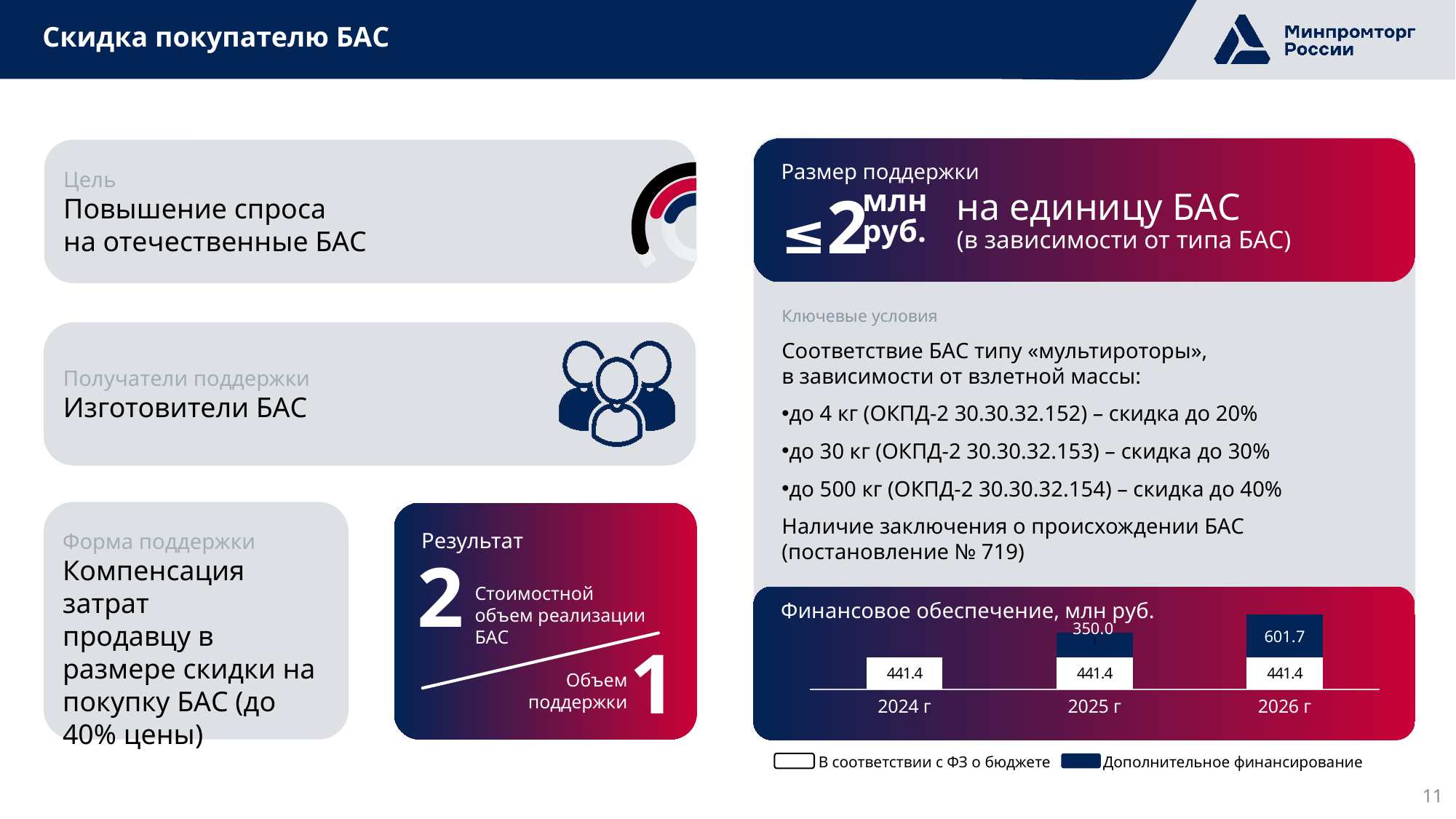
What type of chart is shown under "Финансовое обеспечение, млн руб."? Stacked bar chart In the "Финансовое обеспечение, млн руб." chart, which year has the highest "Дополнительное финансирование" value? 2026 г In the "Финансовое обеспечение, млн руб." chart, what is the total of the stacked bar for 2025 г? 791.4 In the "Финансовое обеспечение, млн руб." chart, what is the value for "Дополнительное финансирование" in 2026 г? 601.7 How many series does the legend of the "Финансовое обеспечение, млн руб." chart list? 2 In the "Финансовое обеспечение, млн руб." chart, is the "Дополнительное финансирование" value for 2026 г larger or smaller than the "В соответствии с ФЗ о бюджете" value for 2026 г? Larger In the "Финансовое обеспечение, млн руб." chart, what is the value for "В соответствии с ФЗ о бюджете" in 2024 г? 441.4 In the "Финансовое обеспечение, млн руб." chart, what is the difference between the "Дополнительное финансирование" values for 2026 г and 2025 г? 251.7 In the "Финансовое обеспечение, млн руб." chart, what is the total of the stacked bar for 2026 г? 1043.1 How many years are shown on the x axis of the "Финансовое обеспечение, млн руб." chart? 3 In the "Финансовое обеспечение, млн руб." chart, does the total bar height rise or fall from 2024 г to 2026 г? Rise In the "Финансовое обеспечение, млн руб." chart, what is the value for "Дополнительное финансирование" in 2025 г? 350.0